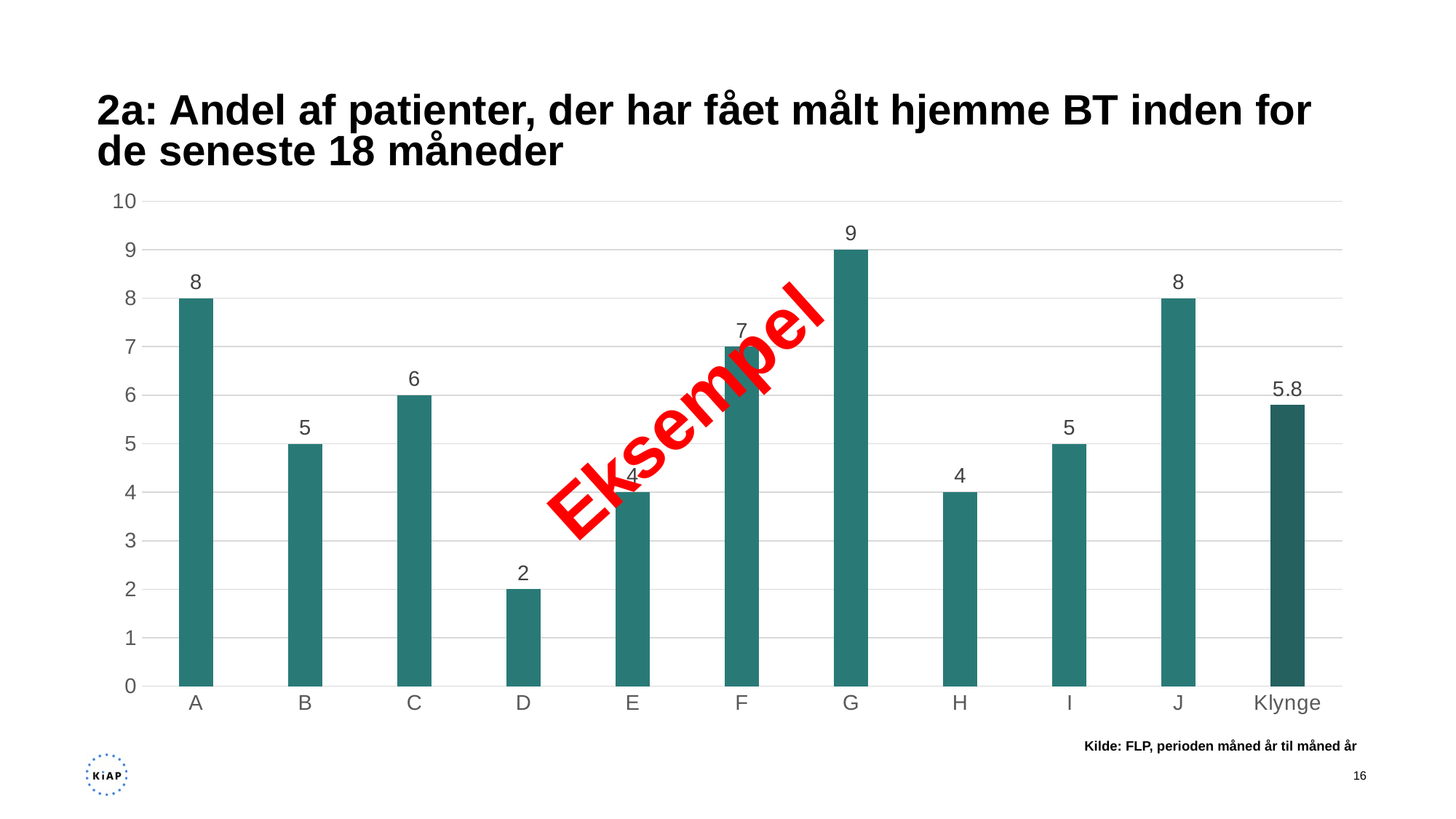
What is the difference between the values for A and Klynge? 2.2 Is the value for F greater or less than 5? greater How many categories are shown on the x axis? 11 What kind of chart is shown on the slide? Bar chart What is the difference between the values for G and D? 7 What is the value for Klynge? 5.8 Which category has the lowest value? D Which is larger, the value for C or the value for I? C What is the value for G? 9 Which category has the highest value? G What is the value for D? 2 What is the title of the chart? 2a: Andel af patienter, der har fået målt hjemme BT inden for de seneste 18 måneder